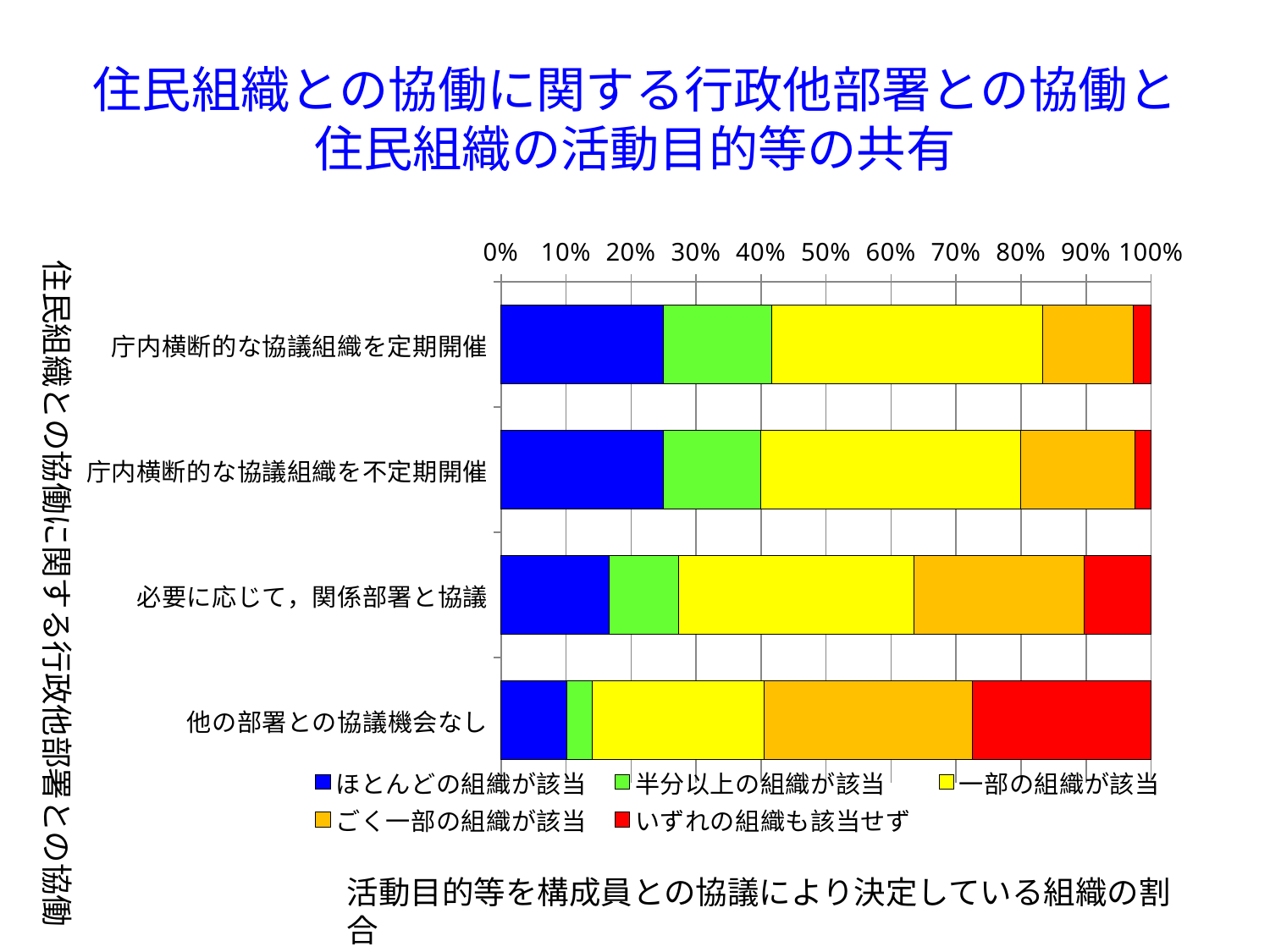
Which category has the largest いずれの組織も該当せず segment? 他の部署との協議機会なし What kind of chart is shown on the slide? stacked bar chart Which category has the smallest ほとんどの組織が該当 segment? 他の部署との協議機会なし Which has the larger 半分以上の組織が該当 segment: 庁内横断的な協議組織を定期開催 or 必要に応じて，関係部署と協議? 庁内横断的な協議組織を定期開催 Is the いずれの組織も該当せず segment for 必要に応じて，関係部署と協議 greater or less than 20%? less Is the ごく一部の組織が該当 segment for 他の部署との協議機会なし greater or less than 20%? greater Is the ほとんどの組織が該当 segment for 庁内横断的な協議組織を定期開催 greater or less than 20%? greater How many categories are plotted on the vertical axis of the chart? 4 What is the first entry in the chart's legend? ほとんどの組織が該当 What colour represents いずれの組織も該当せず in the chart? red How many series does the legend list? 5